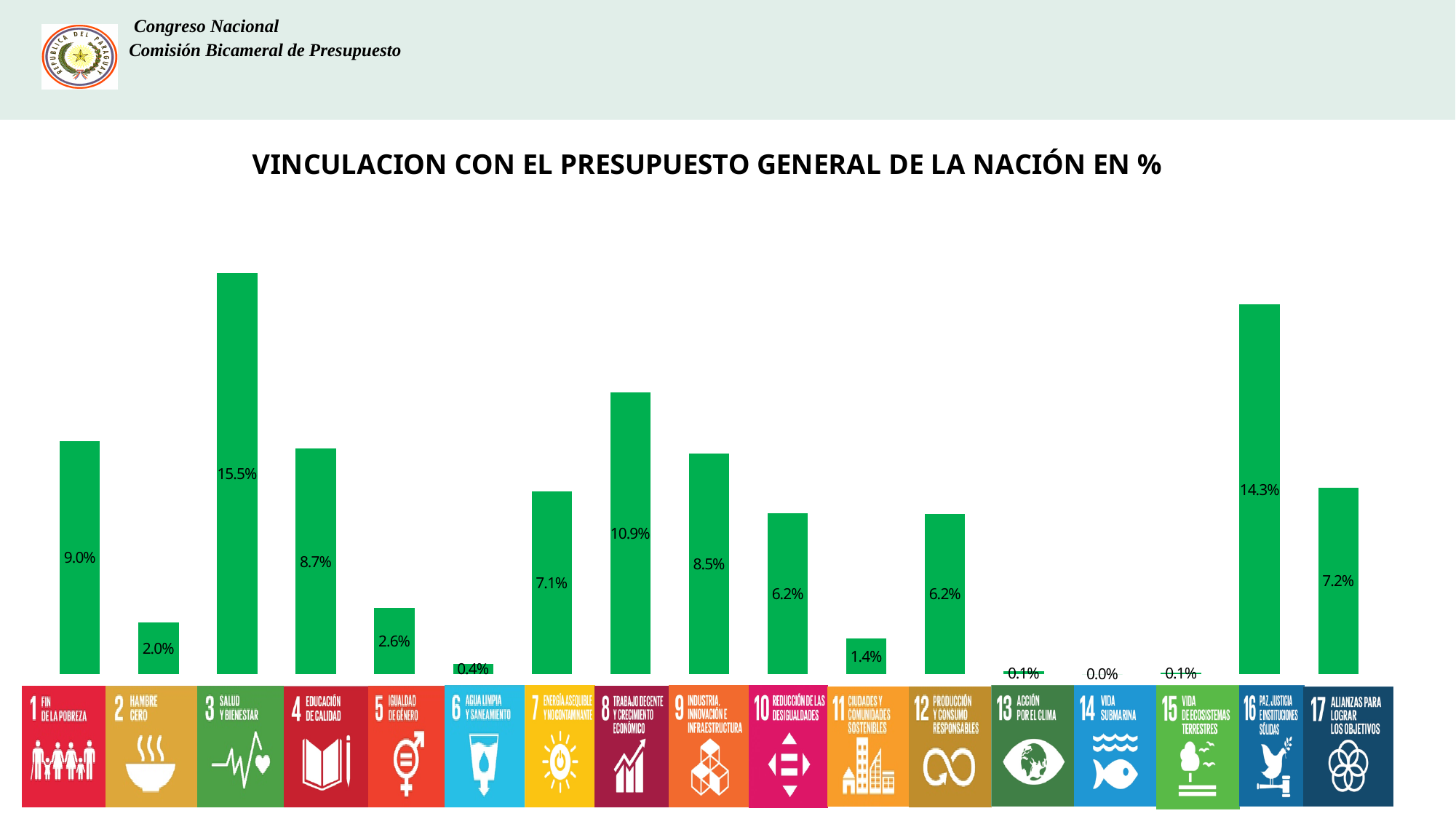
How many categories (SDG goals) are plotted in the chart? 17 Which goal has the lowest value in the chart? 14 Vida Submarina What is the value for goal 8, Trabajo Decente y Crecimiento Económico? 10.9% What is the value for goal 3, Salud y Bienestar? 15.5% What is the value for goal 6, Agua Limpia y Saneamiento? 0.4% What is the chart's title? VINCULACION CON EL PRESUPUESTO GENERAL DE LA NACIÓN EN % What is the value for goal 16, Paz, Justicia e Instituciones Sólidas? 14.3% Which has a larger value, goal 1 (Fin de la Pobreza) or goal 8 (Trabajo Decente y Crecimiento Económico)? 8 Trabajo Decente y Crecimiento Económico Which goal has the highest value in the chart? 3 Salud y Bienestar What is the value for goal 11, Ciudades y Comunidades Sostenibles? 1.4% What kind of chart is shown on the slide? Bar chart What is the difference between the values for goal 3 (Salud y Bienestar) and goal 16 (Paz, Justicia e Instituciones Sólidas)? 1.2 percentage points